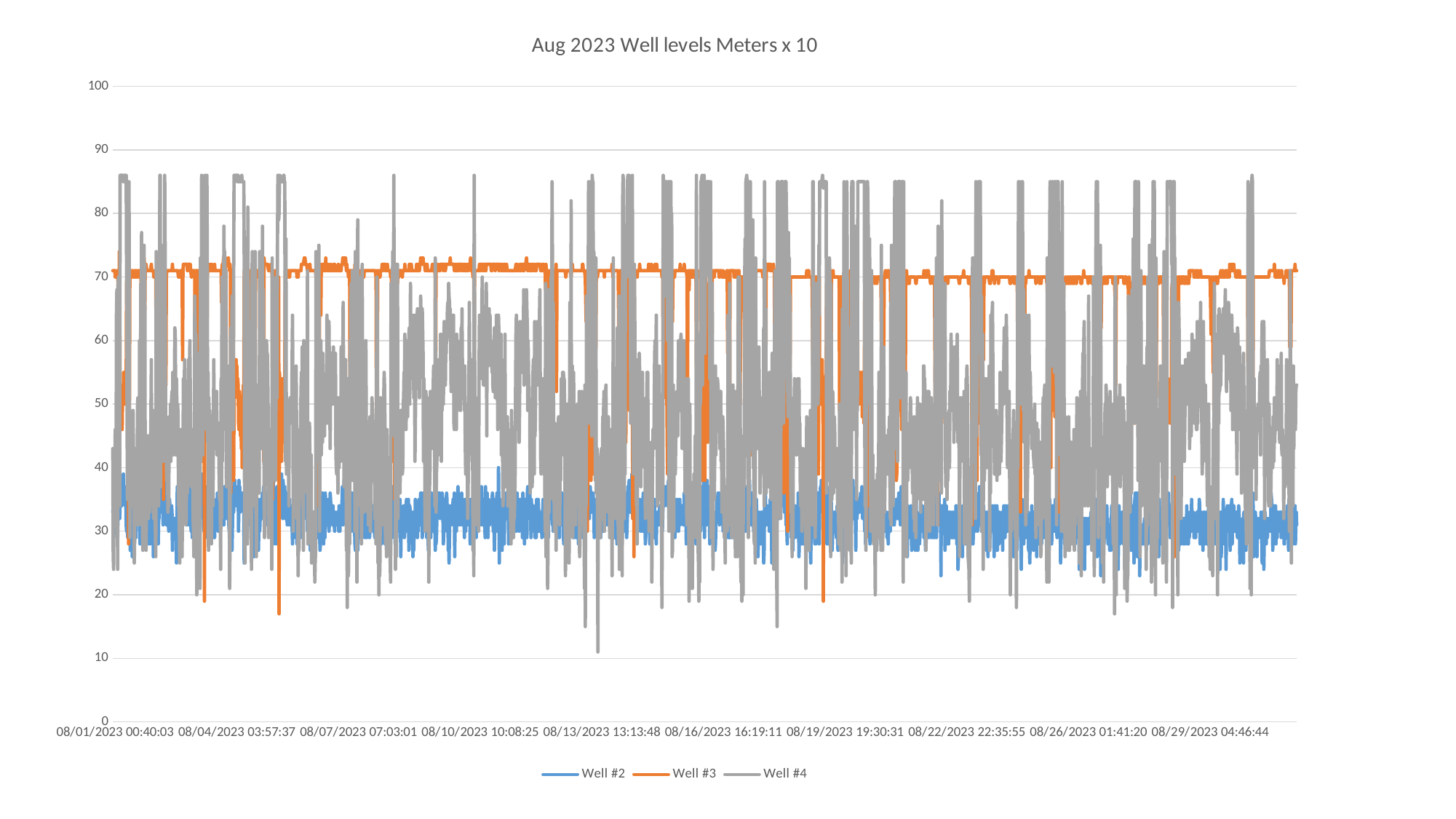
Which series fluctuates the most across the month? Well #4 Which series shows the lowest typical level across the month? Well #2 Which series is drawn in orange? Well #3 What is the maximum value shown on the vertical axis? 100 What kind of chart is shown on the slide? line chart Which series generally stays at a higher level, Well #2 or Well #3? Well #3 Are the highest peaks of Well #4 greater or less than 80? greater How many date labels are shown along the x axis? 10 Is the typical value for Well #3 greater or less than 60? greater Is the typical value for Well #2 greater or less than 40? less How many series does the legend list? 3